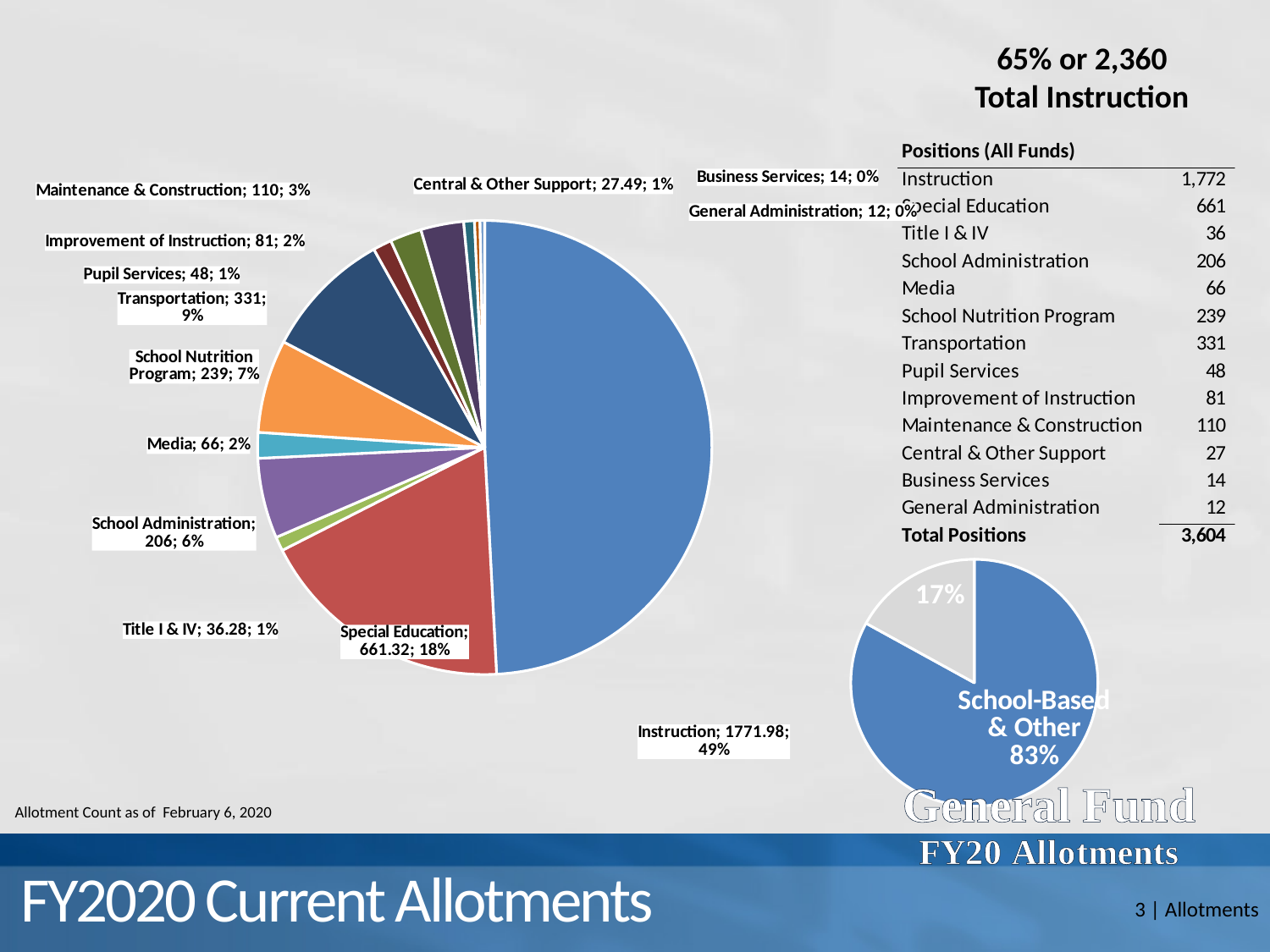
In the large pie chart, what is the difference between the values for Transportation and School Nutrition Program? 92 In the small pie chart at the bottom right, what share is shown for School-Based & Other? 83% In the small pie chart at the bottom right, what percentage is shown for the grey slice? 17% In the large pie chart, what share of the pie does Special Education represent? 18% In the large pie chart, which is larger, the value for Media or the value for Pupil Services? Media In the large pie chart, what value is shown for Transportation? 331 In the large pie chart, what value is shown for Instruction? 1771.98 How many categories are shown in the large pie chart? 13 In the large pie chart, which category has the largest slice? Instruction In the large pie chart, which category has the smallest value? General Administration What type of chart is the large chart on the left of the slide? Pie chart In the large pie chart, what share of the pie does School Administration represent? 6%